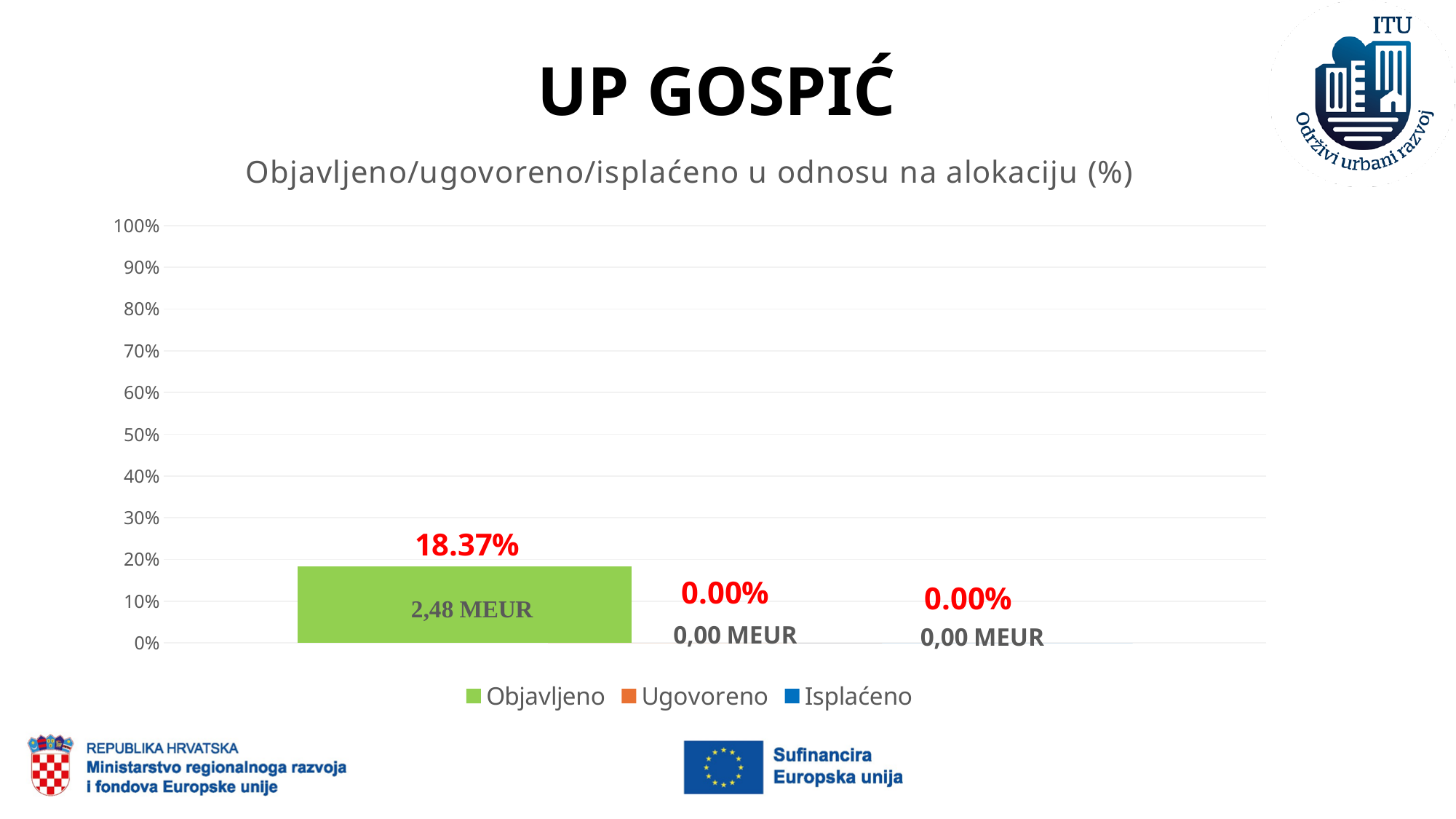
What amount in MEUR is shown on the Objavljeno bar? 2,48 MEUR How many series does the legend list? 3 What is the difference between the Objavljeno and Ugovoreno values? 18.37% Which is larger, the value for Objavljeno or the value for Isplaćeno? Objavljeno What is the value for Isplaćeno? 0.00% What colour is the Objavljeno bar? green What is the title of the chart? Objavljeno/ugovoreno/isplaćeno u odnosu na alokaciju (%) What is the value for Ugovoreno? 0.00% What is the value for Objavljeno? 18.37% Is the value for Objavljeno greater or less than 20%? less Which series has the highest value? Objavljeno What kind of chart is shown on the slide? bar chart